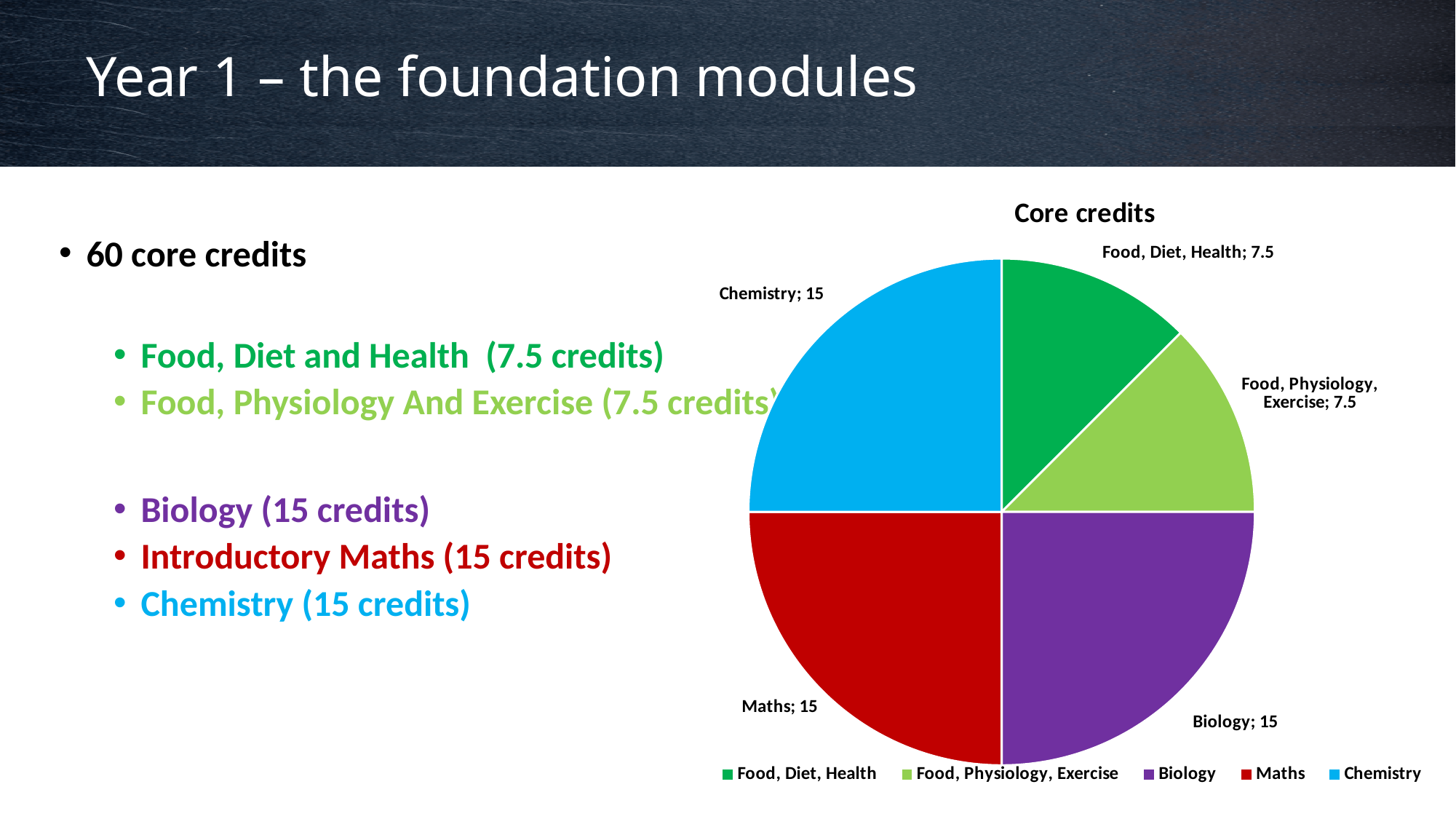
What is the value shown for Food, Physiology, Exercise in the pie chart? 7.5 What type of chart is shown on the slide? Pie chart What colour is the Chemistry slice in the pie chart? Blue What is the value shown for Chemistry in the pie chart? 15 How many entries does the chart legend list? 5 What share of the pie does Food, Diet, Health represent? 12.5% How many slices does the pie chart have? 5 Which is larger in the pie chart, Biology or Food, Diet, Health? Biology What is the title of the chart? Core credits What share of the pie does Biology represent? 25% What is the value shown for Food, Diet, Health in the pie chart? 7.5 What is the difference between the values for Maths and Food, Physiology, Exercise? 7.5